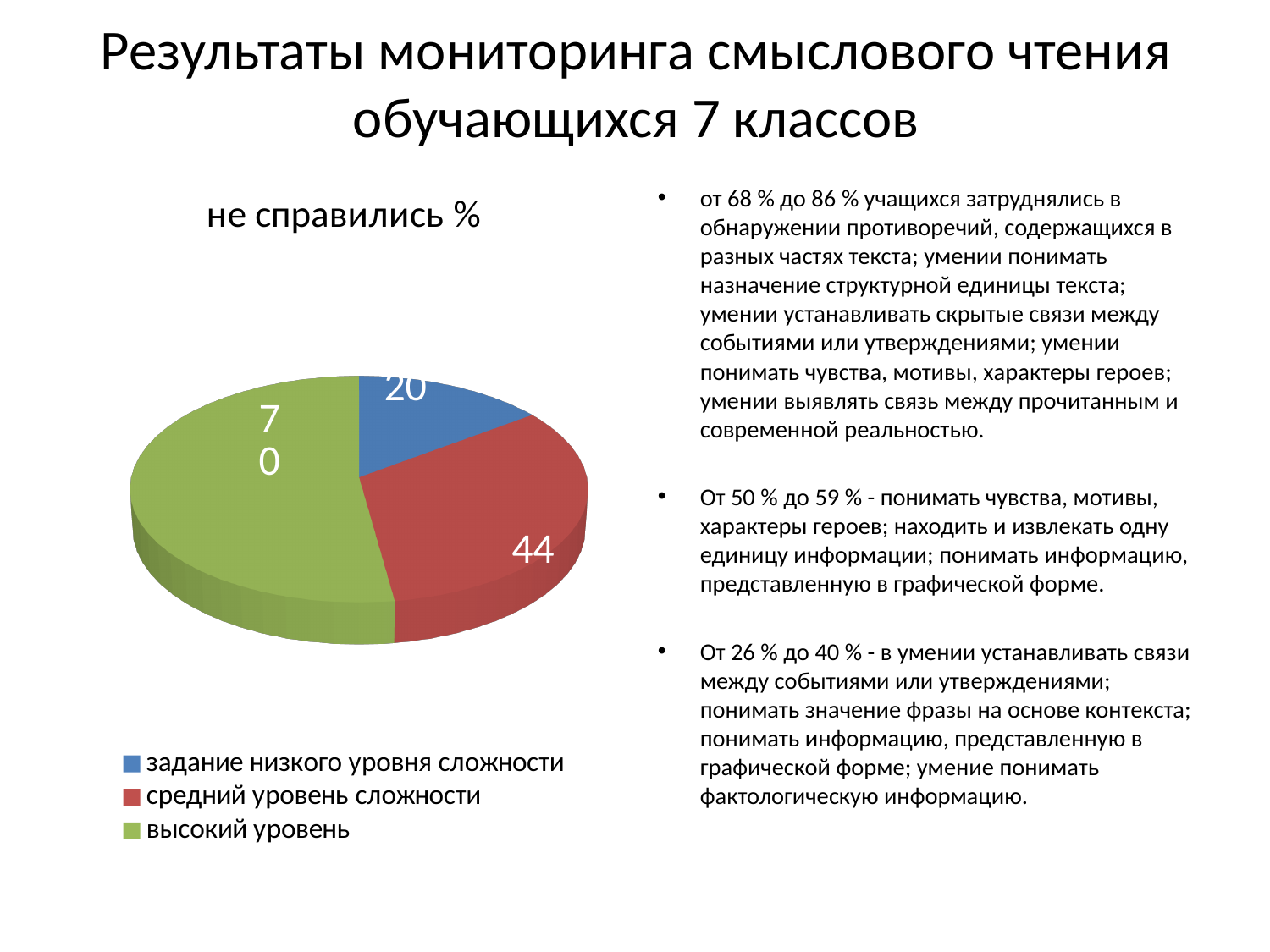
What is the difference between the values for "средний уровень сложности" and "задание низкого уровня сложности"? 24 What is the value for "высокий уровень"? 70 Which is larger: the value for "средний уровень сложности" or the value for "задание низкого уровня сложности"? средний уровень сложности What is the title of the chart? не справились % What is the difference between the values for "высокий уровень" and "средний уровень сложности"? 26 What type of chart is shown on the slide? pie chart Which category has the largest slice of the pie? высокий уровень What is the value for "задание низкого уровня сложности"? 20 Which category has the smallest slice of the pie? задание низкого уровня сложности Which colour represents "высокий уровень" in the chart? green How many categories does the pie chart have? 3 What is the value for "средний уровень сложности"? 44